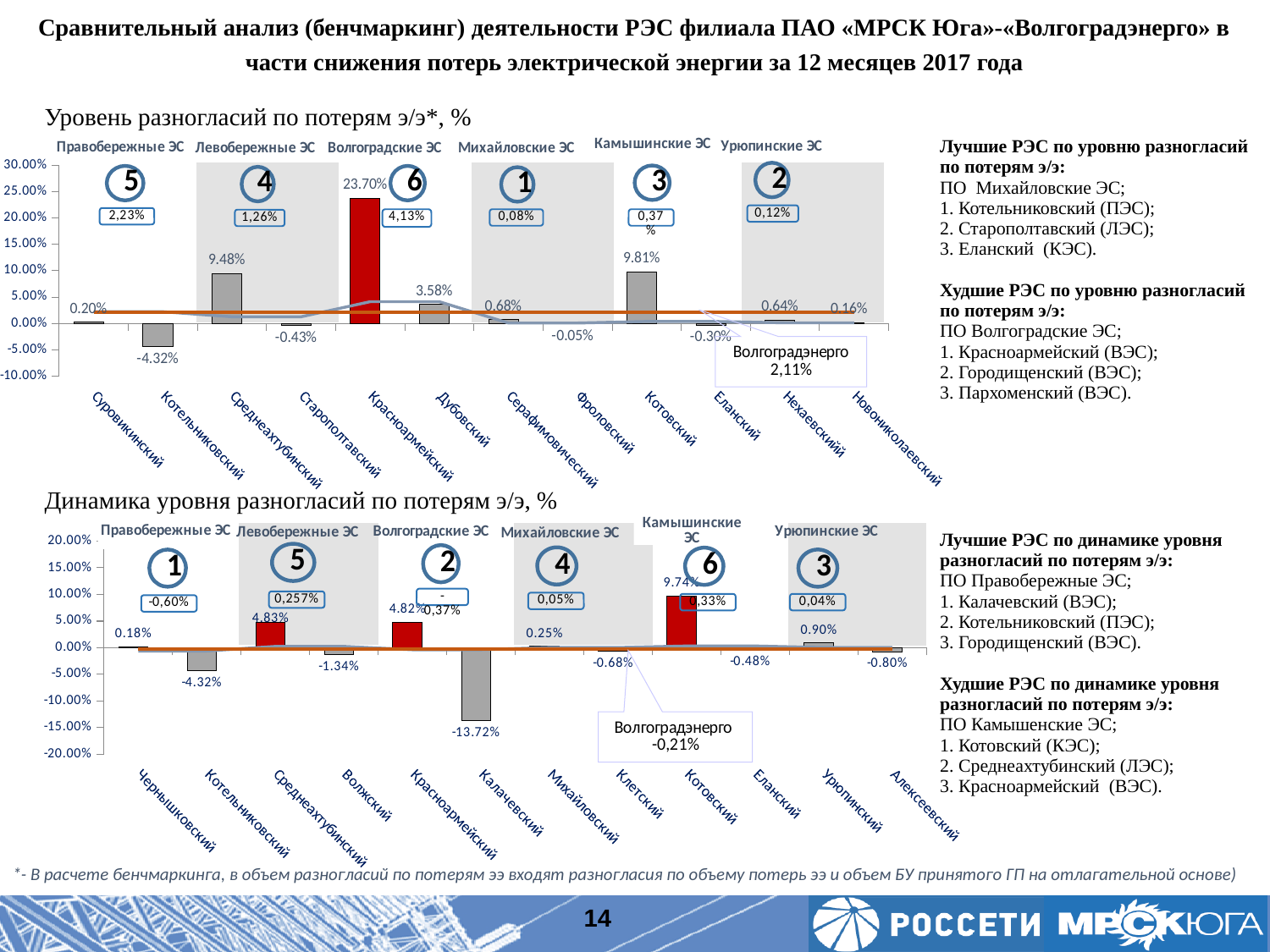
On the chart 'Уровень разногласий по потерям э/э*, %', what is the value for Красноармейский? 23.70% What kind of chart is 'Динамика уровня разногласий по потерям э/э, %'? combination bar and line chart On the chart 'Динамика уровня разногласий по потерям э/э, %', what is the value for Калачевский? -13.72% On the chart 'Динамика уровня разногласий по потерям э/э, %', what is the difference between the values for Котовский and Среднеахтубинский? 4.91% On the chart 'Уровень разногласий по потерям э/э*, %', which category has the lowest value? Котельниковский On the chart 'Уровень разногласий по потерям э/э*, %', is the value for Красноармейский greater or less than 20.00%? greater On the chart 'Динамика уровня разногласий по потерям э/э, %', which category has the lowest value? Калачевский On the chart 'Уровень разногласий по потерям э/э*, %', what is the difference between the values for Котовский and Среднеахтубинский? 0.33% On the chart 'Динамика уровня разногласий по потерям э/э, %', which is larger: the value for Котовский or the value for Среднеахтубинский? Котовский On the chart 'Динамика уровня разногласий по потерям э/э, %', which category has the highest value? Котовский On the chart 'Уровень разногласий по потерям э/э*, %', how many categories are shown on the x axis? 12 On the chart 'Уровень разногласий по потерям э/э*, %', which category has the highest value? Красноармейский